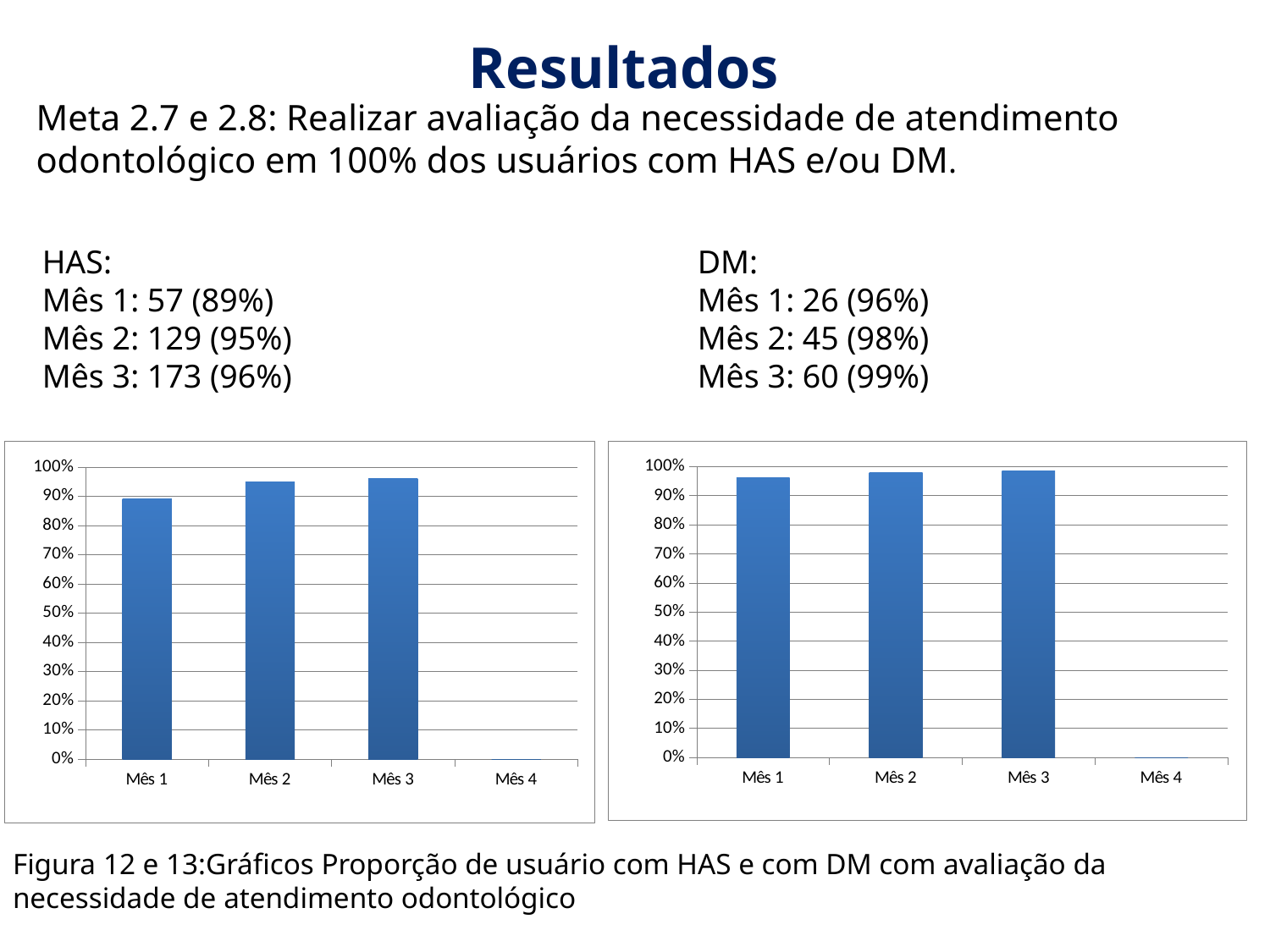
According to the slide, what proportion is plotted for Mês 1 in the left chart (HAS)? 89% In the left chart (HAS), is the value for Mês 1 greater or less than 90%? less Do the bar values in the right chart (DM) rise or fall from Mês 1 to Mês 3? rise According to the slide, what proportion is plotted for Mês 3 in the right chart (DM)? 99% What kind of chart is the left chart (HAS) on the slide? bar chart In the left chart (HAS), is the value for Mês 2 greater or less than 90%? greater In the left chart (HAS), which bar is taller, Mês 1 or Mês 3? Mês 3 How many categories are shown on the x axis of the right chart (DM)? 4 In the right chart (DM), is the value for Mês 1 greater or less than 90%? greater Do the bar values in the left chart (HAS) rise or fall from Mês 1 to Mês 3? rise Which x-axis category has no bar in both charts? Mês 4 In the left chart (HAS), which month has the lowest bar? Mês 1